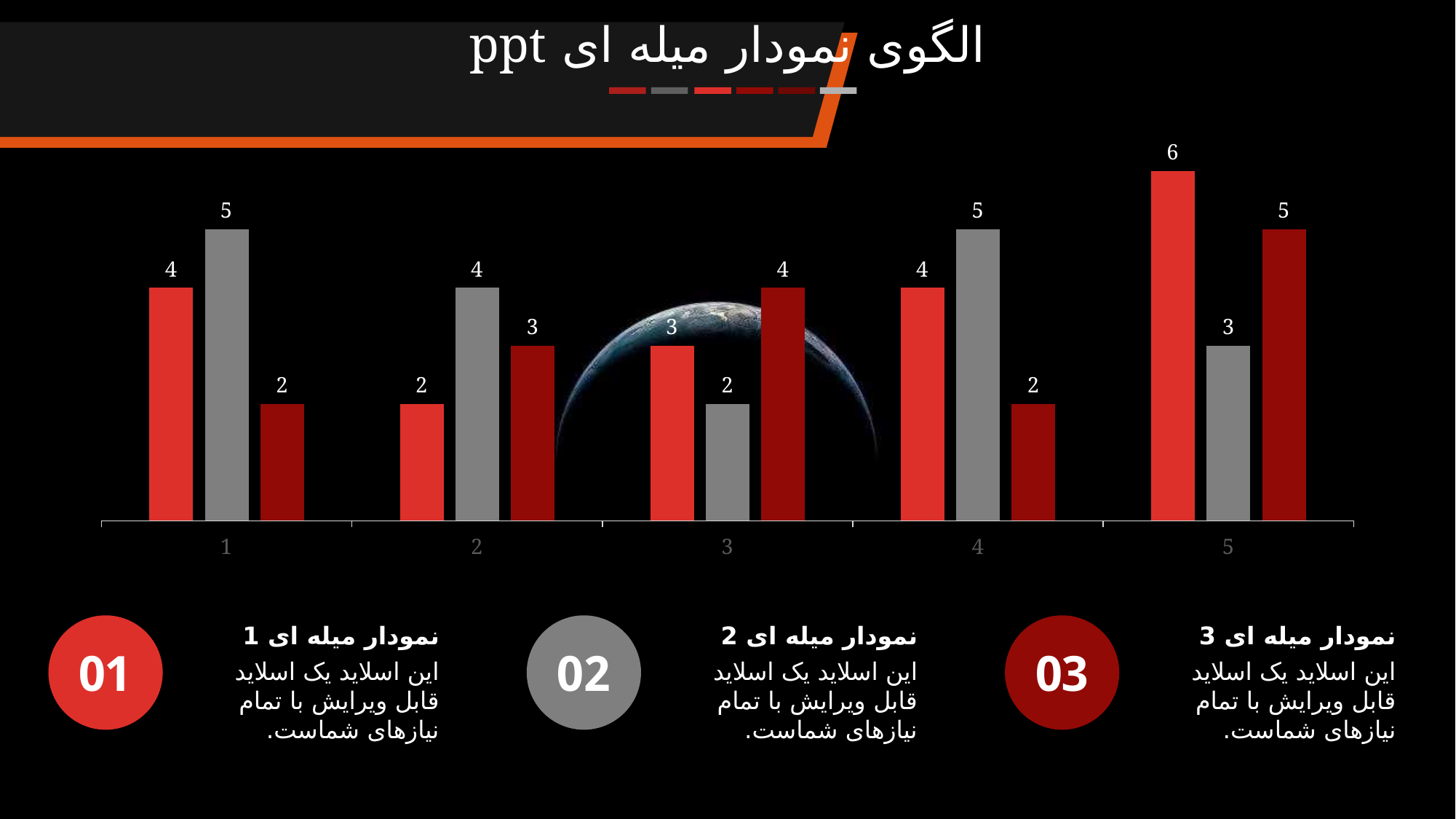
What is the value of the gray bar for category 1? 5 Which category has the tallest bar on the chart? 5 How many bars are plotted for each category on the chart? 3 What is the difference between the bright red bar and the gray bar for category 5? 3 How many categories are shown on the x axis of the chart? 5 What is the title of the slide? الگوی نمودار میله ای ppt What is the total of the three bars for category 1? 11 What is the value of the bright red bar for category 5? 6 What kind of chart is shown on the slide? bar chart What is the value of the dark red bar for category 3? 4 Which category has the lowest gray bar? 3 For category 2, which is larger: the gray bar or the dark red bar? gray bar